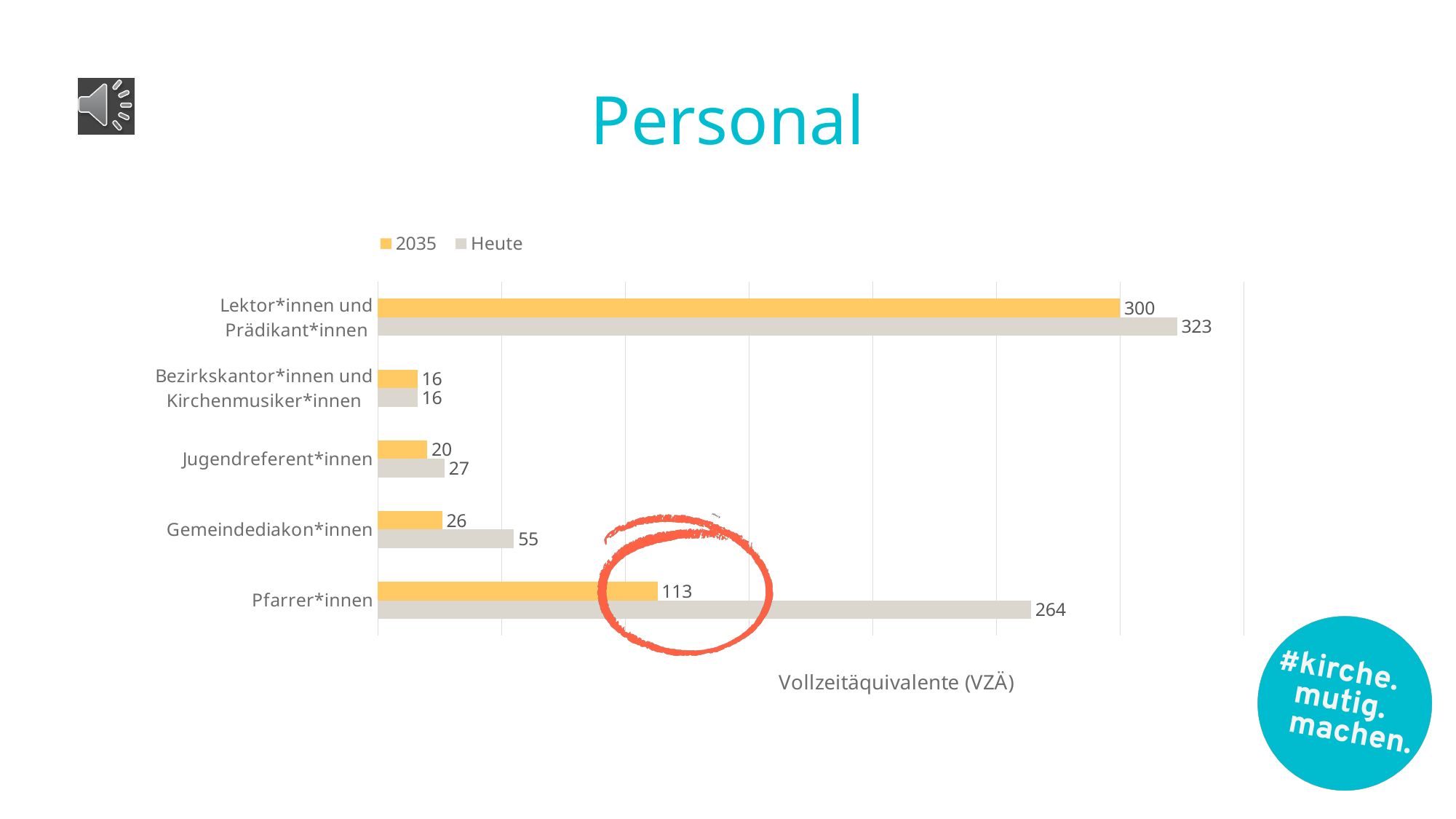
How many categories are shown on the chart? 5 How many series does the legend list? 2 Which category has the lowest 2035 value? Bezirkskantor*innen und Kirchenmusiker*innen What is the difference between the Heute and 2035 values for Lektor*innen und Prädikant*innen? 23 What is the Heute value for Gemeindediakon*innen? 55 Which is larger for Gemeindediakon*innen, the 2035 value or the Heute value? Heute What is the Heute value for Pfarrer*innen? 264 What is the 2035 value for Pfarrer*innen? 113 What is the difference between the Heute and 2035 values for Pfarrer*innen? 151 Which category has the highest Heute value? Lektor*innen und Prädikant*innen What kind of chart is shown on the slide? Bar chart What is the 2035 value for Jugendreferent*innen? 20